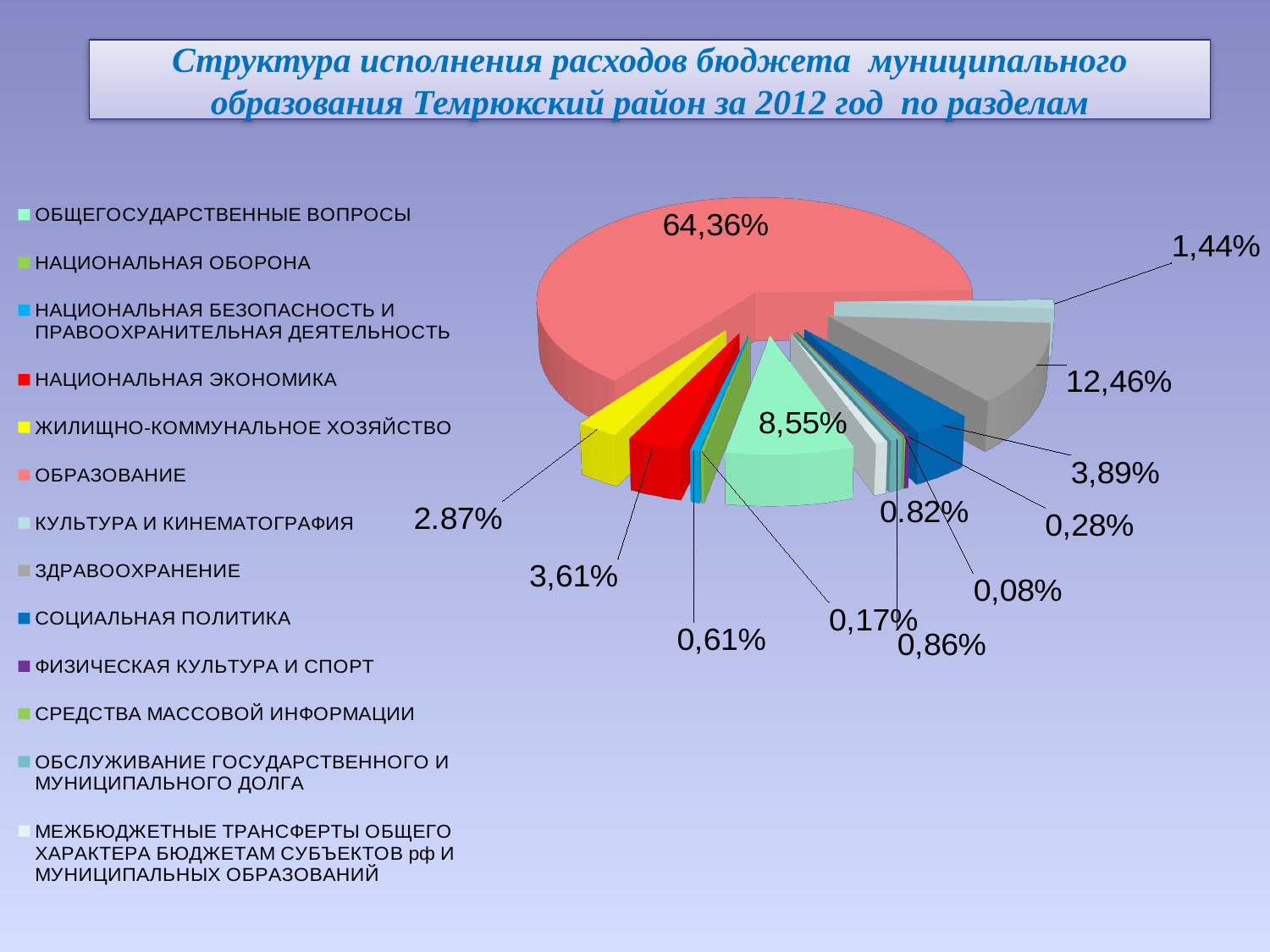
What share of the pie does ОБРАЗОВАНИЕ (the pink slice) have? 64,36% Which is larger: the share for ЗДРАВООХРАНЕНИЕ or the share for СОЦИАЛЬНАЯ ПОЛИТИКА? ЗДРАВООХРАНЕНИЕ By how many percentage points does the share of ОБРАЗОВАНИЕ exceed the share of ЗДРАВООХРАНЕНИЕ? 51,90% What share of the pie does ЗДРАВООХРАНЕНИЕ (the gray slice) have? 12,46% What share of the pie does НАЦИОНАЛЬНАЯ ЭКОНОМИКА (the red slice) have? 3,61% Which category has the largest share of the pie? ОБРАЗОВАНИЕ How many categories does the legend list? 13 What kind of chart is shown on the slide? pie chart What is the smallest percentage labelled on the pie chart? 0,08%